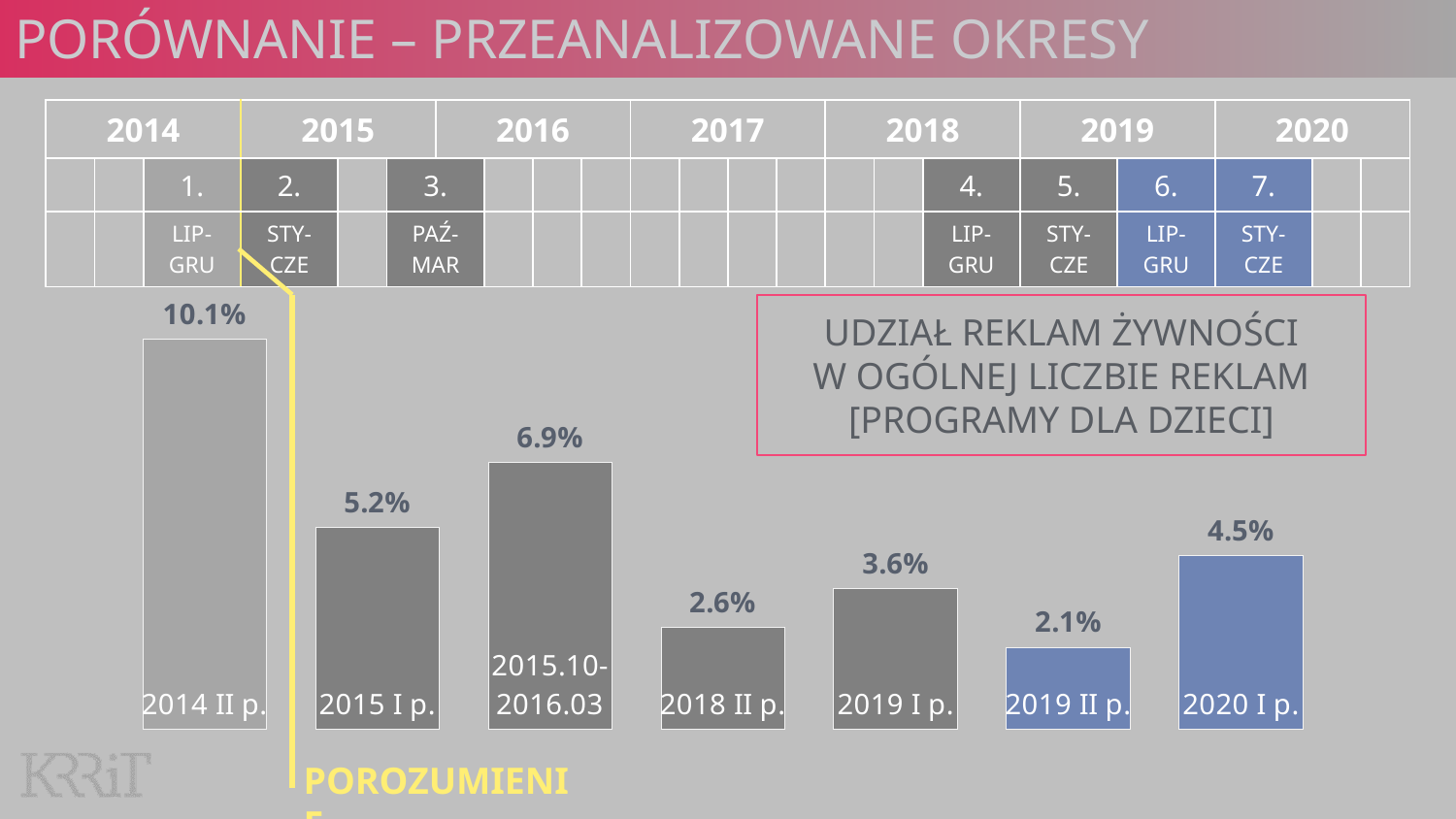
How many bars are shown in the chart? 7 What is the value for 2019 II p.? 2.1% Which is larger, the value for 2018 II p. or the value for 2019 I p.? 2019 I p. What is the value for 2014 II p.? 10.1% What is the difference between the values for 2020 I p. and 2019 II p.? 2.4% What is the title shown in the box next to the chart? UDZIAŁ REKLAM ŻYWNOŚCI W OGÓLNEJ LICZBIE REKLAM [PROGRAMY DLA DZIECI] Which period has the highest value? 2014 II p. What is the value for 2020 I p.? 4.5% What kind of chart is shown on the slide? Bar chart Which period has the lowest value? 2019 II p. What is the value for the 2015.10-2016.03 period? 6.9% What is the difference between the values for 2014 II p. and 2015 I p.? 4.9%